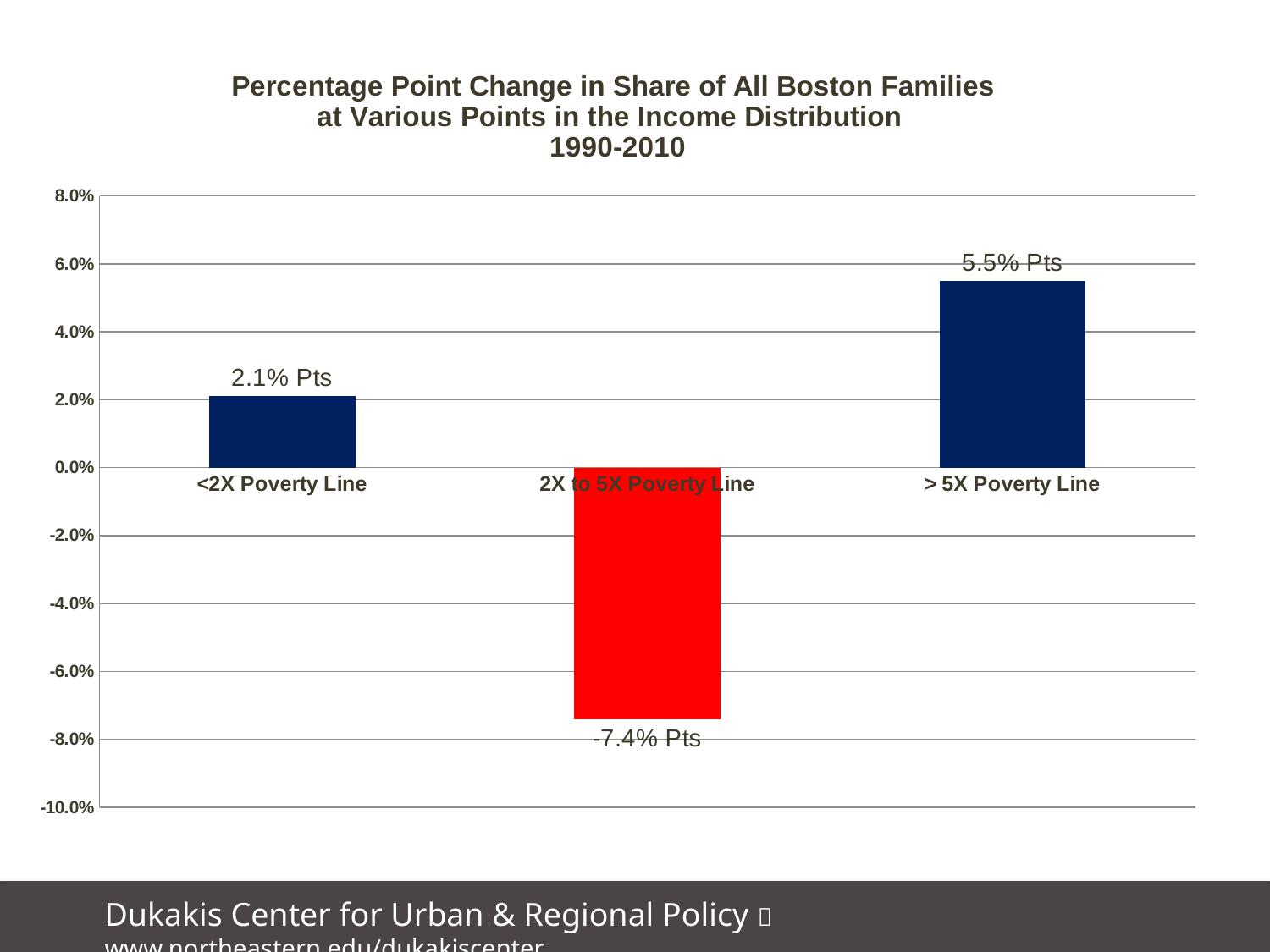
What colour is the bar for 2X to 5X Poverty Line? red How many income groups are shown in the chart? 3 What is the percentage point change for families below 2X the poverty line? 2.1% Pts Which income group shows the lowest percentage point change? 2X to 5X Poverty Line Which is larger, the change for <2X Poverty Line or the change for > 5X Poverty Line? > 5X Poverty Line Is the value for 2X to 5X Poverty Line greater or less than -6.0%? less What is the difference between the change for > 5X Poverty Line and the change for <2X Poverty Line? 3.4% Pts What is the percentage point change for families between 2X and 5X the poverty line? -7.4% Pts What time period does the chart title cover? 1990-2010 What kind of chart is shown on the slide? bar chart What is the percentage point change for families above 5X the poverty line? 5.5% Pts